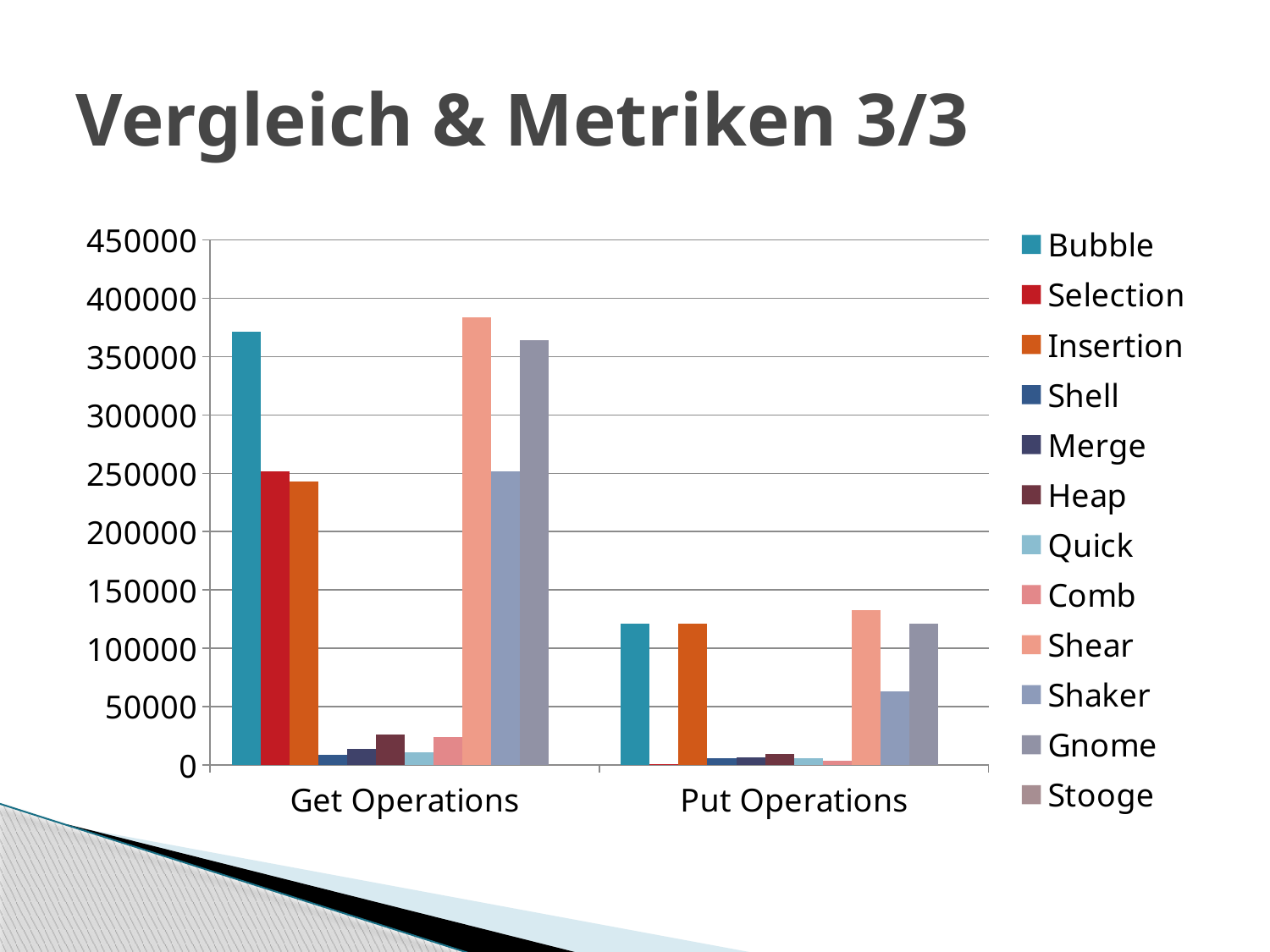
What kind of chart is shown on the slide? bar chart Is the value for Bubble in Get Operations greater or less than 350000? greater Is the value for Shaker in Put Operations greater or less than 100000? less What is the title of the slide containing the chart? Vergleich & Metriken 3/3 How many series does the chart's legend list? 12 How many categories are shown on the x axis of the chart? 2 In Put Operations, which is larger: the value for Shaker or the value for Gnome? Gnome Which series has the highest value in Put Operations? Shear Does the value for Bubble rise or fall from Get Operations to Put Operations? fall Is the value for Heap in Get Operations greater or less than 50000? less In Get Operations, which is larger: the value for Bubble or the value for Selection? Bubble